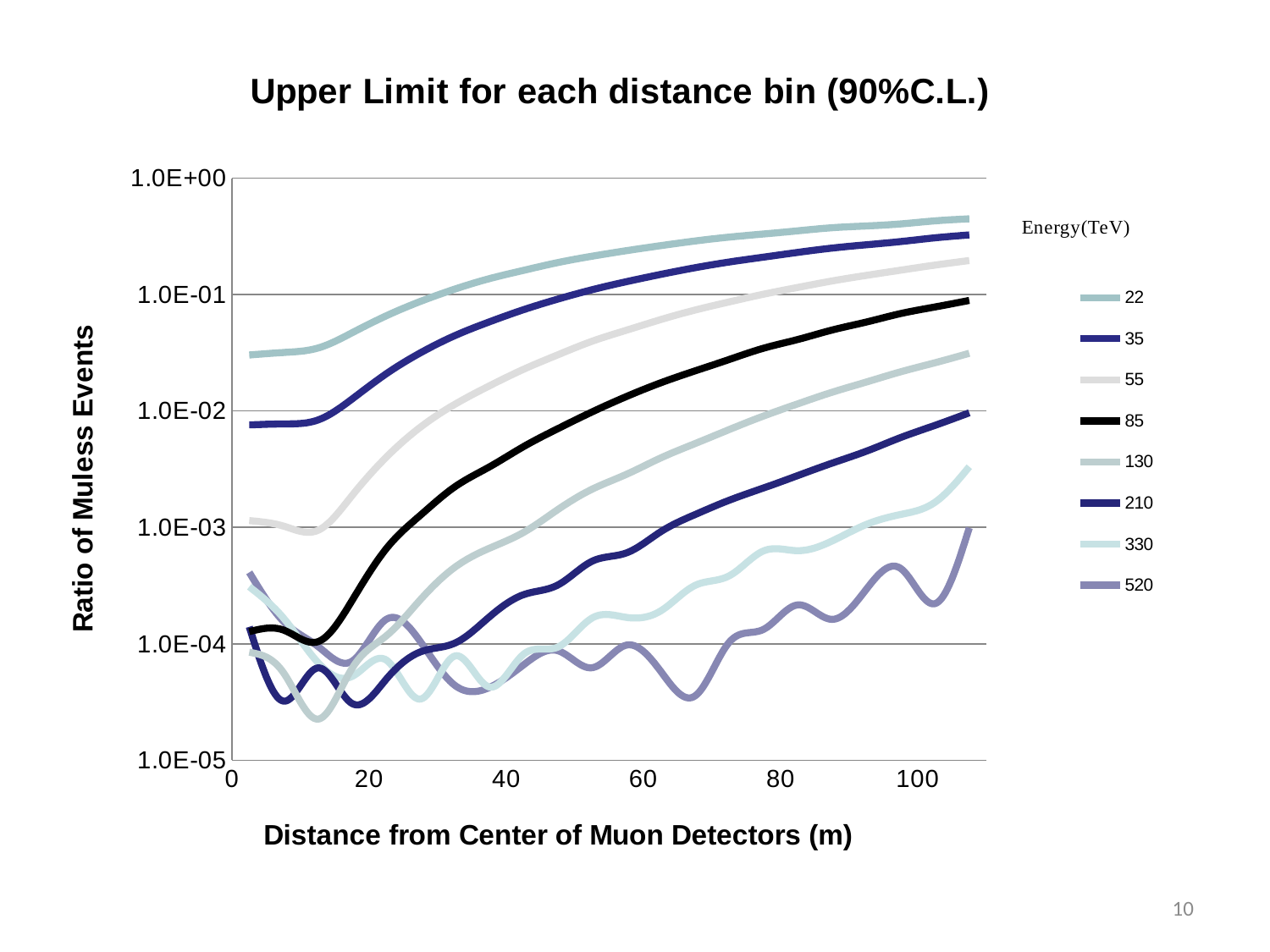
What is the title of the chart? Upper Limit for each distance bin (90%C.L.) Is the value for the 520 TeV series at 60 m greater or less than 1.0E-03? less Is the value for the 85 TeV series at 100 m greater or less than 1.0E-01? less Which series has the highest value at a distance of 100 m? 22 What is the label of the x axis? Distance from Center of Muon Detectors (m) Is the value for the 35 TeV series at 40 m greater or less than 1.0E-02? greater Which series has the lowest value at a distance of 100 m? 520 What kind of chart is shown on the slide? line chart How many series does the legend list? 8 At a distance of 100 m, which series has the larger value, 22 or 520? 22 Does the 22 TeV series rise or fall as distance increases along the x axis? rise